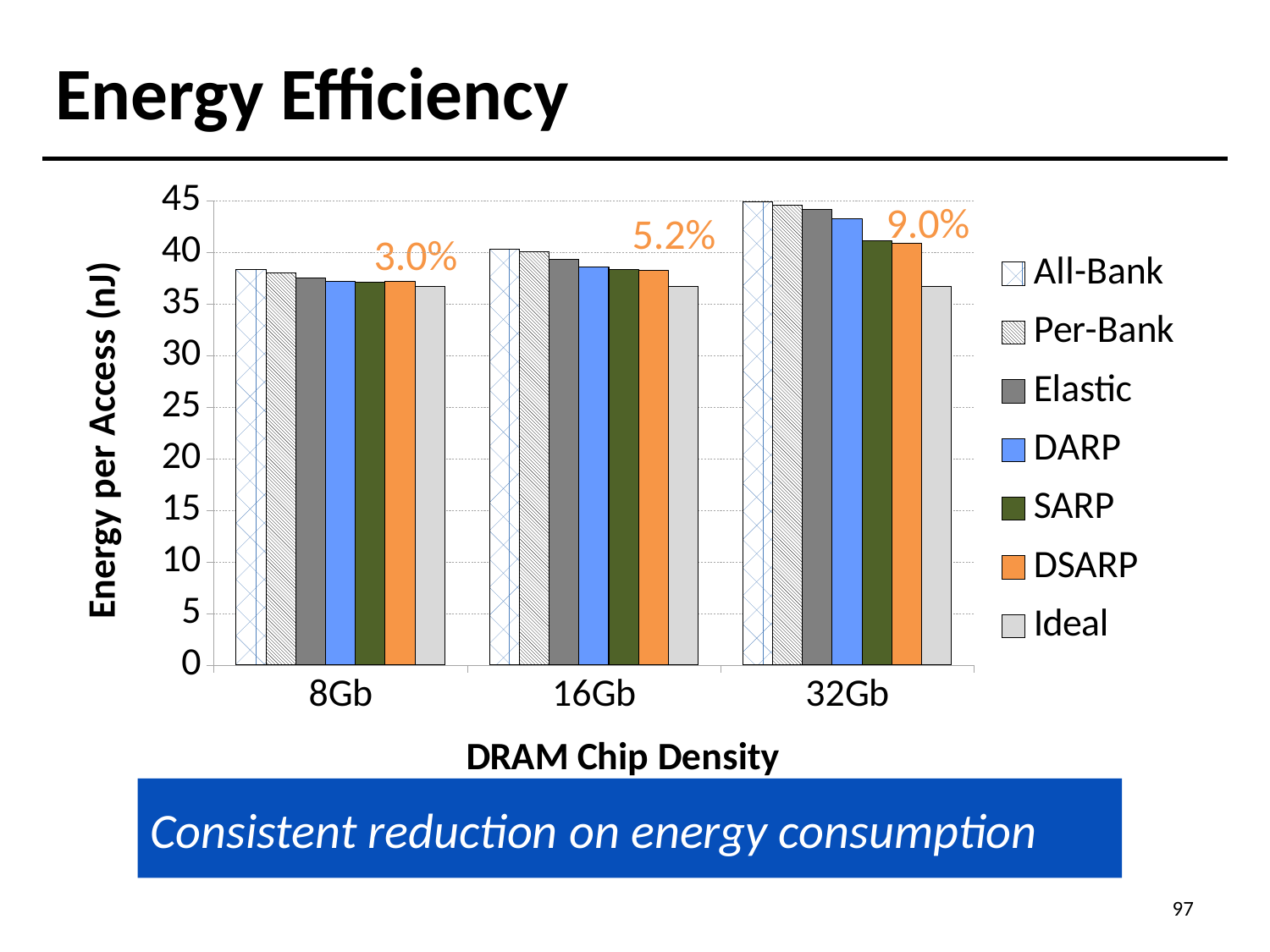
How many DRAM chip density categories are shown on the x axis? 3 Which is larger, the All-Bank value at 32Gb or the All-Bank value at 8Gb? 32Gb Is the DSARP value at 16Gb greater or less than 40? less How many series does the legend list? 7 What is the label of the y axis? Energy per Access (nJ) Is the DARP value at 32Gb greater or less than 40? greater Is the Ideal value at 8Gb greater or less than 40? less What kind of chart is shown on the slide? bar chart What percentage is annotated above the 32Gb group of bars? 9.0% At 32Gb, which is larger, the All-Bank value or the Ideal value? All-Bank Does the All-Bank energy per access rise or fall as DRAM chip density increases from 8Gb to 32Gb? rise